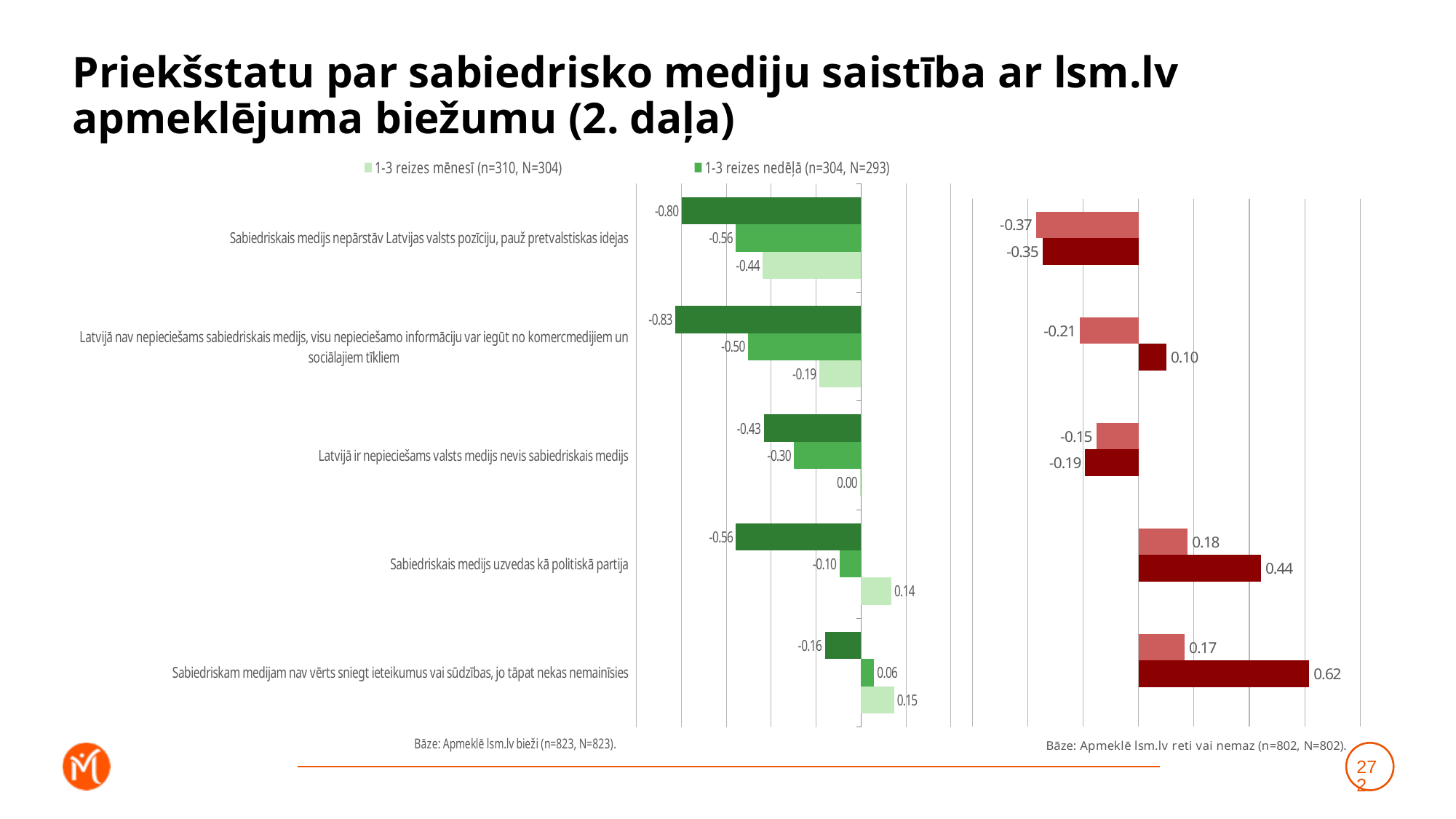
In the right (red) chart, which light red bar is larger: 'Sabiedriskais medijs nepārstāv Latvijas valsts pozīciju, pauž pretvalstiskas idejas' or 'Sabiedriskais medijs uzvedas kā politiskā partija'? Sabiedriskais medijs uzvedas kā politiskā partija What type of chart is the left (green) chart? Bar chart In the left (green) chart, what is the value of the '1-3 reizes mēnesī' series for 'Sabiedriskais medijs uzvedas kā politiskā partija'? 0.14 In the left (green) chart, what is the value of the '1-3 reizes mēnesī' series for 'Latvijā ir nepieciešams valsts medijs nevis sabiedriskais medijs'? 0.00 In the right (red) chart, which category has the highest dark red bar value? Sabiedriskam medijam nav vērts sniegt ieteikumus vai sūdzības, jo tāpat nekas nemainīsies How many series does the legend above the charts list? 2 What base (Bāze) is stated below the right (red) chart? Apmeklē lsm.lv reti vai nemaz (n=802, N=802) In the left (green) chart, which category has the lowest value among the darkest green bars? Latvijā nav nepieciešams sabiedriskais medijs, visu nepieciešamo informāciju var iegūt no komercmedijiem un sociālajiem tīkliem How many categories (statements) are shown in the left (green) chart? 5 In the left (green) chart, what is the value of the '1-3 reizes nedēļā' series for 'Latvijā nav nepieciešams sabiedriskais medijs, visu nepieciešamo informāciju var iegūt no komercmedijiem un sociālajiem tīkliem'? -0.50 In the right (red) chart, what is the difference between the dark red values for 'Sabiedriskam medijam nav vērts sniegt ieteikumus vai sūdzības, jo tāpat nekas nemainīsies' and 'Sabiedriskais medijs uzvedas kā politiskā partija'? 0.18 In the right (red) chart, what is the value of the dark red bar for 'Sabiedriskam medijam nav vērts sniegt ieteikumus vai sūdzības, jo tāpat nekas nemainīsies'? 0.62